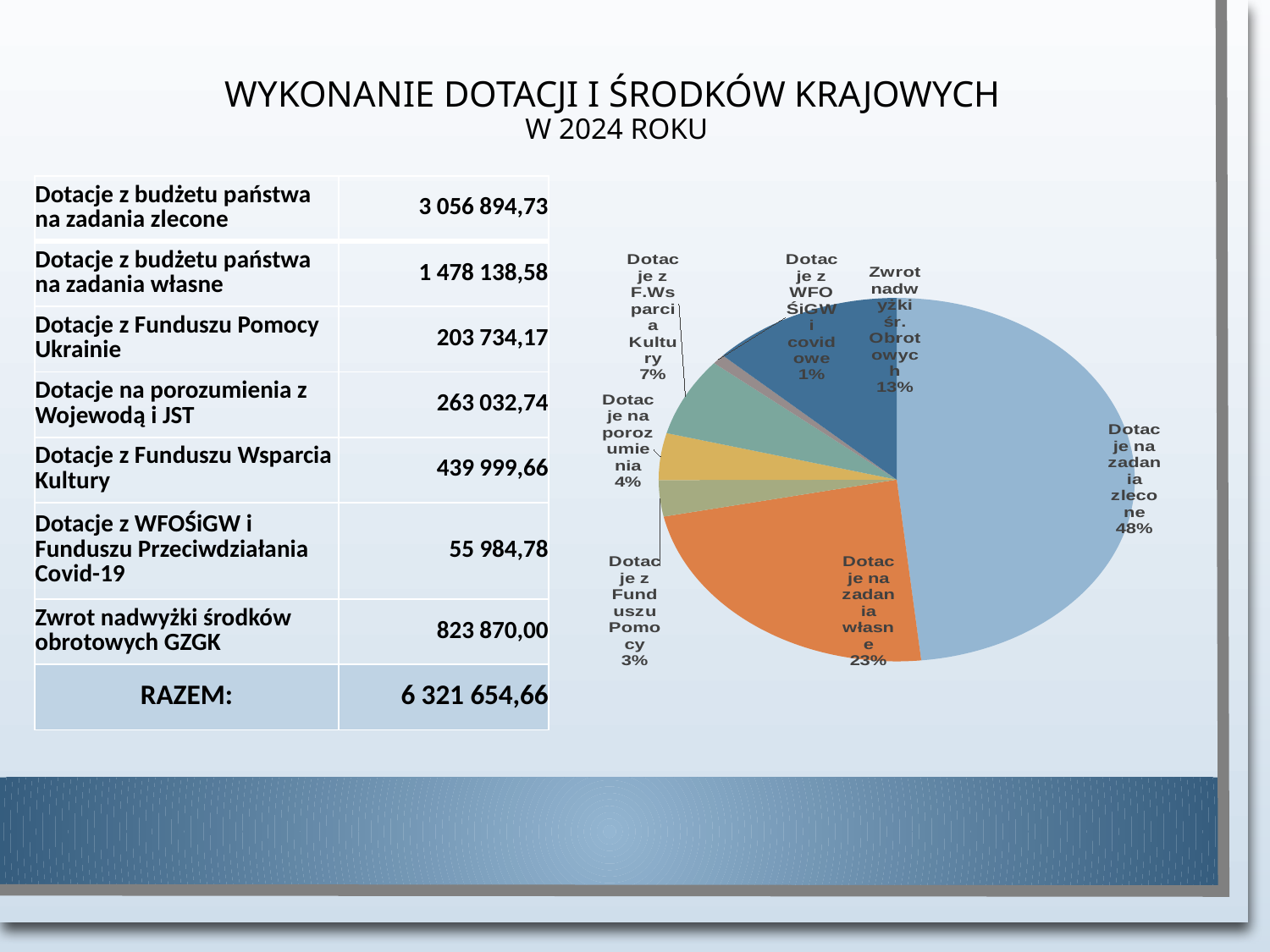
Which slice of the pie chart is the smallest? Dotacje z WFOŚiGW i covidowe What share of the pie is labelled for "Dotacje na zadania własne"? 23% What share of the pie is labelled for "Zwrot nadwyżki śr. Obrotowych"? 13% What colour is the largest slice of the pie chart? light blue Which slice is larger: "Dotacje na porozumienia" or "Dotacje z F.Wsparcia Kultury"? Dotacje z F.Wsparcia Kultury Which slice of the pie chart is the largest? Dotacje na zadania zlecone What share of the pie is labelled for "Dotacje z F.Wsparcia Kultury"? 7% How many slices does the pie chart have? 7 By how many percentage points does the share for "Dotacje na zadania zlecone" exceed the share for "Dotacje na zadania własne"? 25 What kind of chart is shown on the slide? pie chart